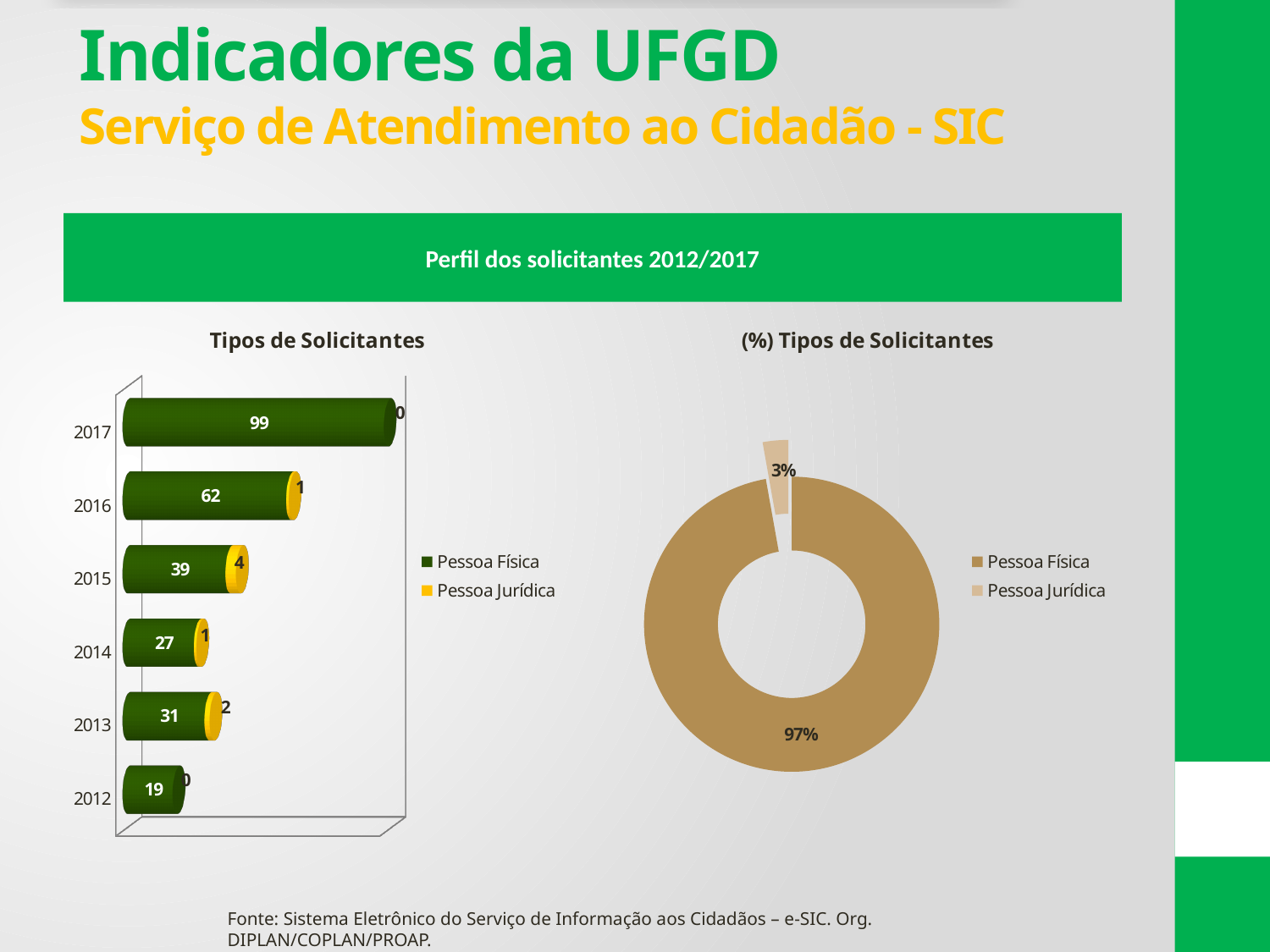
In the 'Tipos de Solicitantes' chart, which year has the lowest value for Pessoa Física? 2012 In the 'Tipos de Solicitantes' chart, which is larger for Pessoa Física: 2013 or 2014? 2013 How many years are shown in the 'Tipos de Solicitantes' chart? 6 In the 'Tipos de Solicitantes' chart, which year has the highest value for Pessoa Física? 2017 In the 'Tipos de Solicitantes' chart, what is the value for Pessoa Física in 2012? 19 In the '(%) Tipos de Solicitantes' chart, what share does Pessoa Jurídica have? 3% In the '(%) Tipos de Solicitantes' chart, what share does Pessoa Física have? 97% In the 'Tipos de Solicitantes' chart, what is the value for Pessoa Jurídica in 2015? 4 What kind of chart is 'Tipos de Solicitantes'? Bar chart In the 'Tipos de Solicitantes' chart, what is the difference between the Pessoa Física values for 2017 and 2016? 37 How many series does the legend of the 'Tipos de Solicitantes' chart list? 2 In the 'Tipos de Solicitantes' chart, what is the value for Pessoa Física in 2017? 99